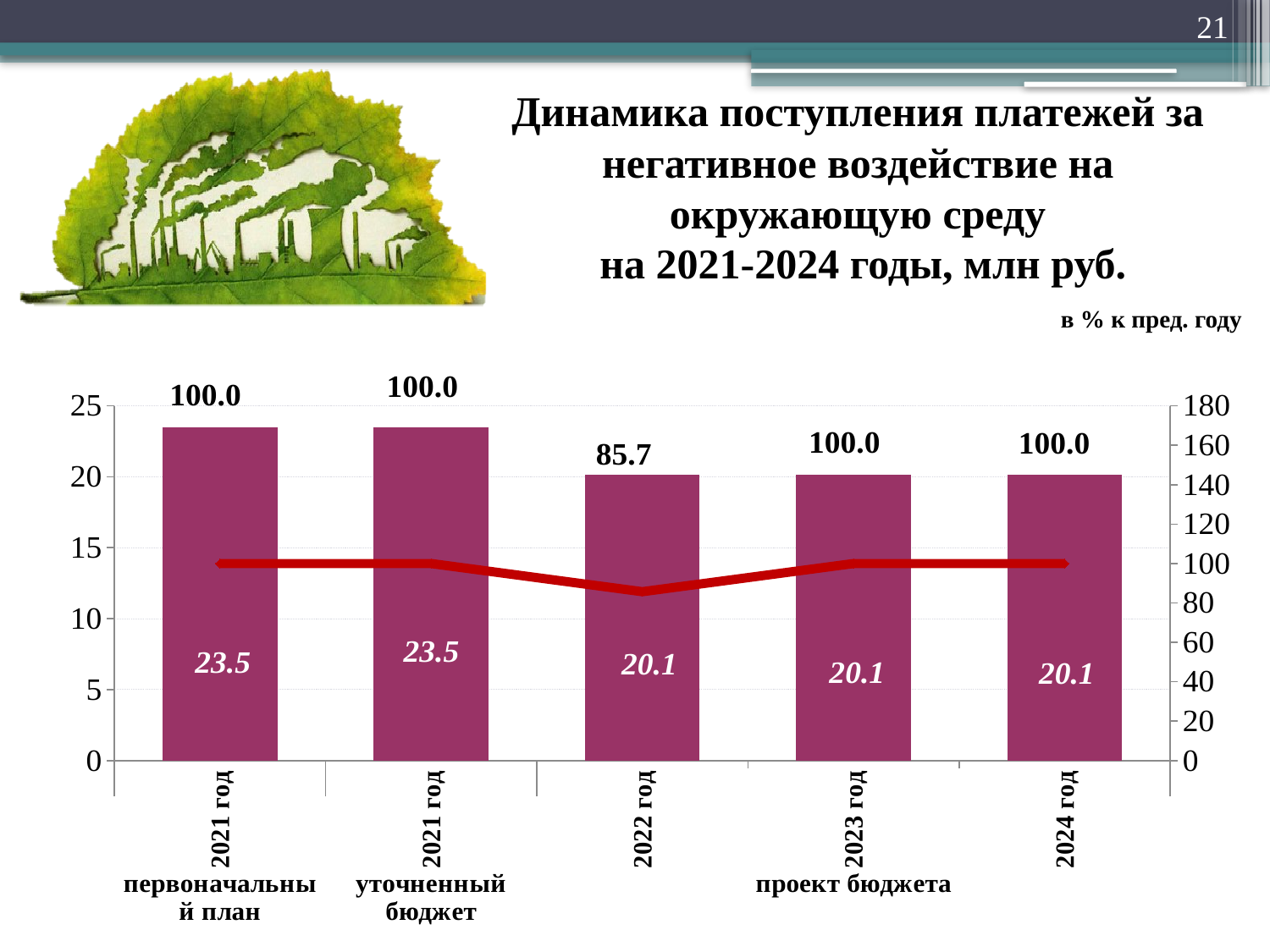
What is the bar value for 2022 год? 20.1 Which category has the lowest line value (в % к пред. году)? 2022 год What is the line value (в % к пред. году) for 2024 год? 100.0 What is the bar value for 2024 год? 20.1 What is the line value (в % к пред. году) for 2022 год? 85.7 What is the bar value for 2021 год (первоначальный план)? 23.5 What is the title of the chart? Динамика поступления платежей за негативное воздействие на окружающую среду на 2021-2024 годы, млн руб. What is the maximum value shown on the right-hand axis? 180 What is the difference between the bar value for 2021 год (уточненный бюджет) and the bar value for 2022 год? 3.4 How many bars are plotted on the chart? 5 Which is larger: the bar value for 2021 год (первоначальный план) or the bar value for 2023 год? 2021 год (первоначальный план) Do the bar values rise or fall from 2021 год to 2024 год? fall